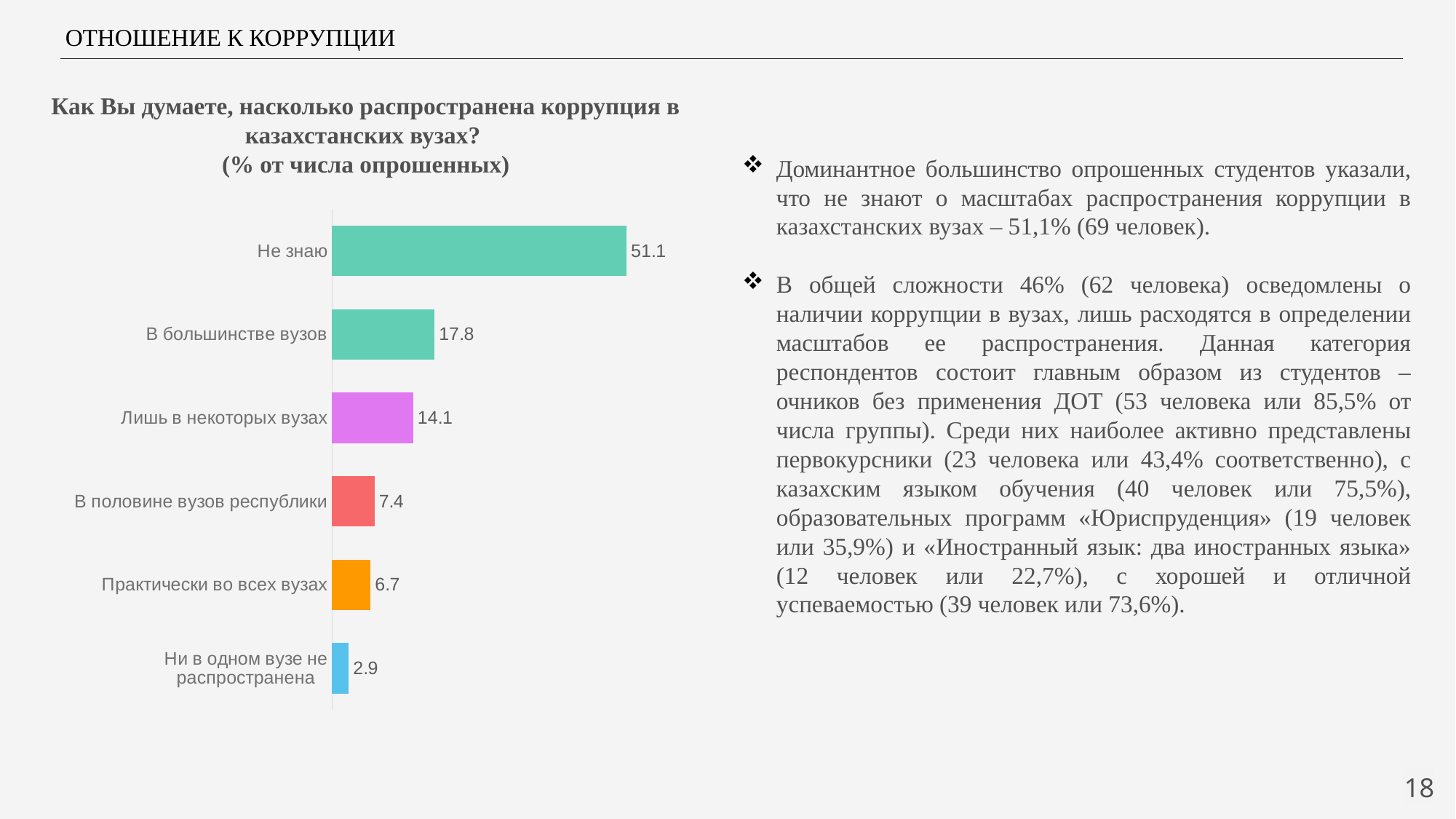
What value is shown for "Лишь в некоторых вузах"? 14.1 Which category has the lowest value? Ни в одном вузе не распространена What colour is the bar for "Практически во всех вузах"? Orange What is the difference between the values for "Не знаю" and "В большинстве вузов"? 33.3 What value is shown for "В большинстве вузов"? 17.8 What is the difference between the values for "Лишь в некоторых вузах" and "В половине вузов республики"? 6.7 What kind of chart is shown on the slide? Bar chart What value is shown for "Ни в одном вузе не распространена"? 2.9 How many categories are shown in the chart? 6 Which is larger: the value for "В половине вузов республики" or "Практически во всех вузах"? В половине вузов республики Which category has the highest value? Не знаю What value is shown for "Не знаю"? 51.1